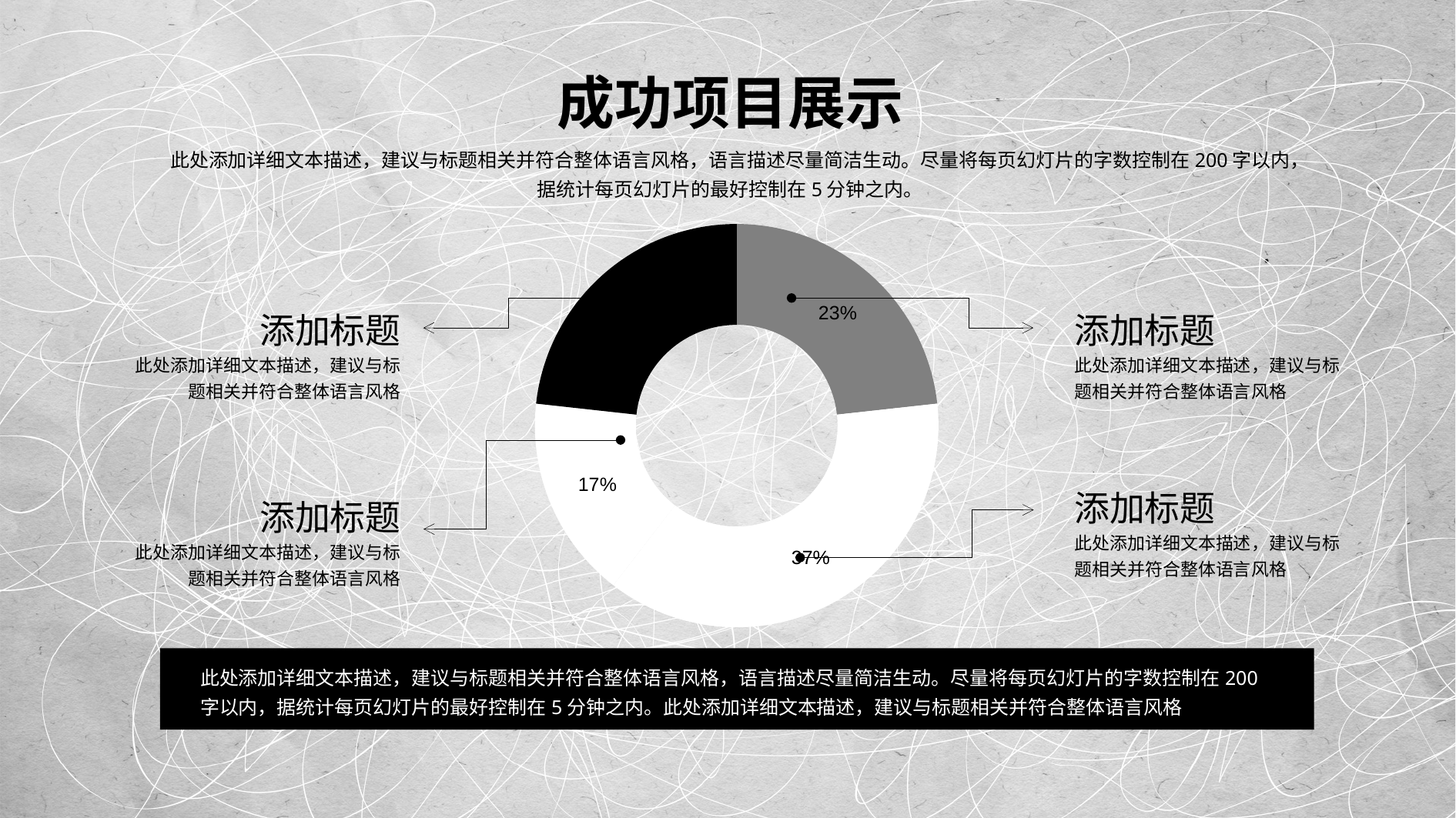
What percentage is labelled on the gray slice of the doughnut chart? 23% Which colour slice of the doughnut chart is the largest? white What kind of chart is shown on the slide? doughnut (pie) chart Is the gray slice of the doughnut chart larger or smaller than the white slice? smaller What is the title of the slide containing the chart? 成功项目展示 How many colours (slice shades) are used in the doughnut chart? 3